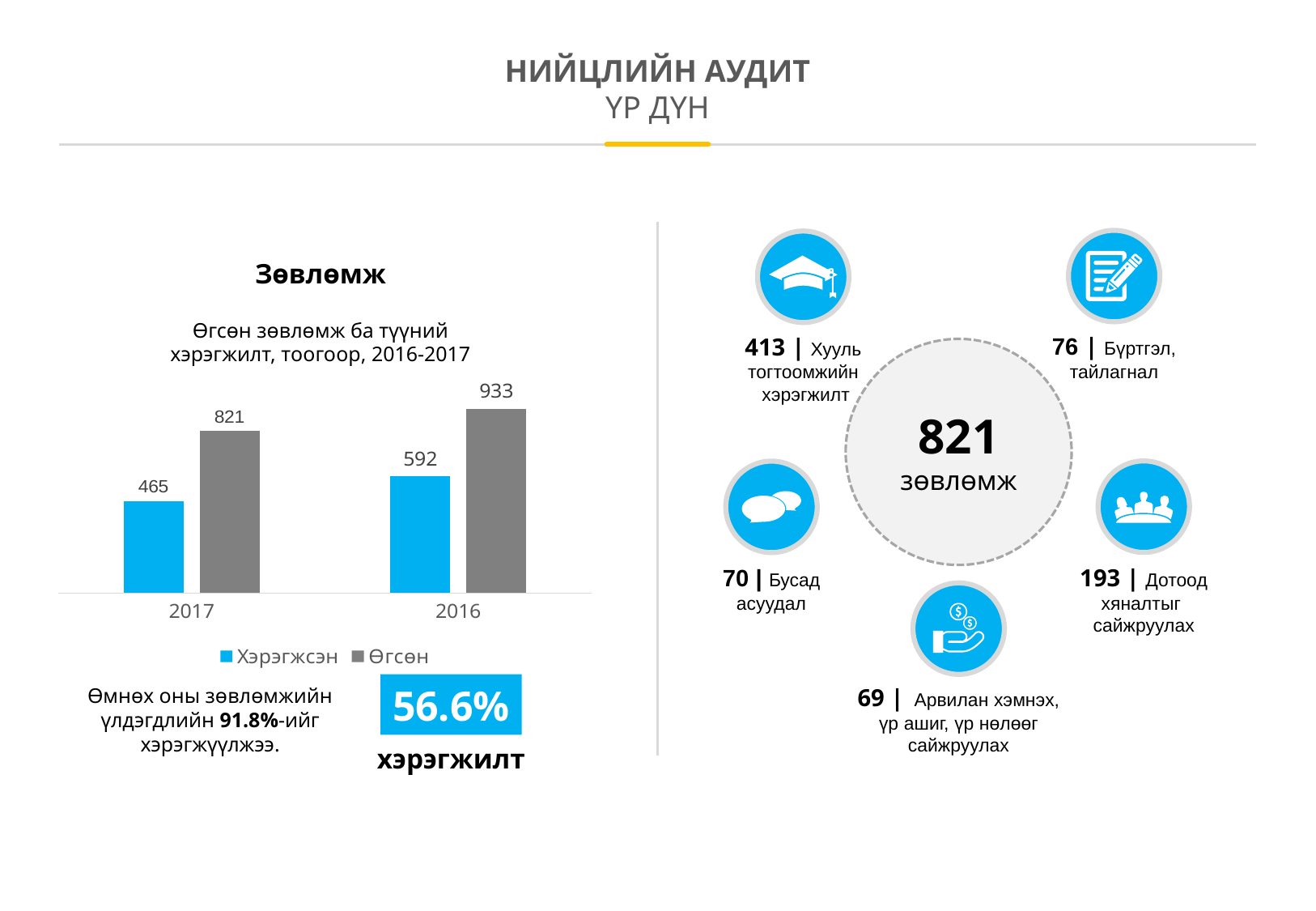
Which colour represents the Өгсөн series in the chart? Grey What is the value of Хэрэгжсэн for 2017? 465 What is the value of Өгсөн for 2017? 821 What is the difference between the Өгсөн values for 2016 and 2017? 112 Which is larger, Хэрэгжсэн for 2016 or Хэрэгжсэн for 2017? Хэрэгжсэн for 2016 What is the difference between Өгсөн and Хэрэгжсэн for 2017? 356 What kind of chart is shown on the slide? Bar chart Which year has the lowest Хэрэгжсэн value? 2017 How many series does the chart legend list? 2 What is the value of Хэрэгжсэн for 2016? 592 What is the value of Өгсөн for 2016? 933 Which year has the highest Өгсөн value? 2016